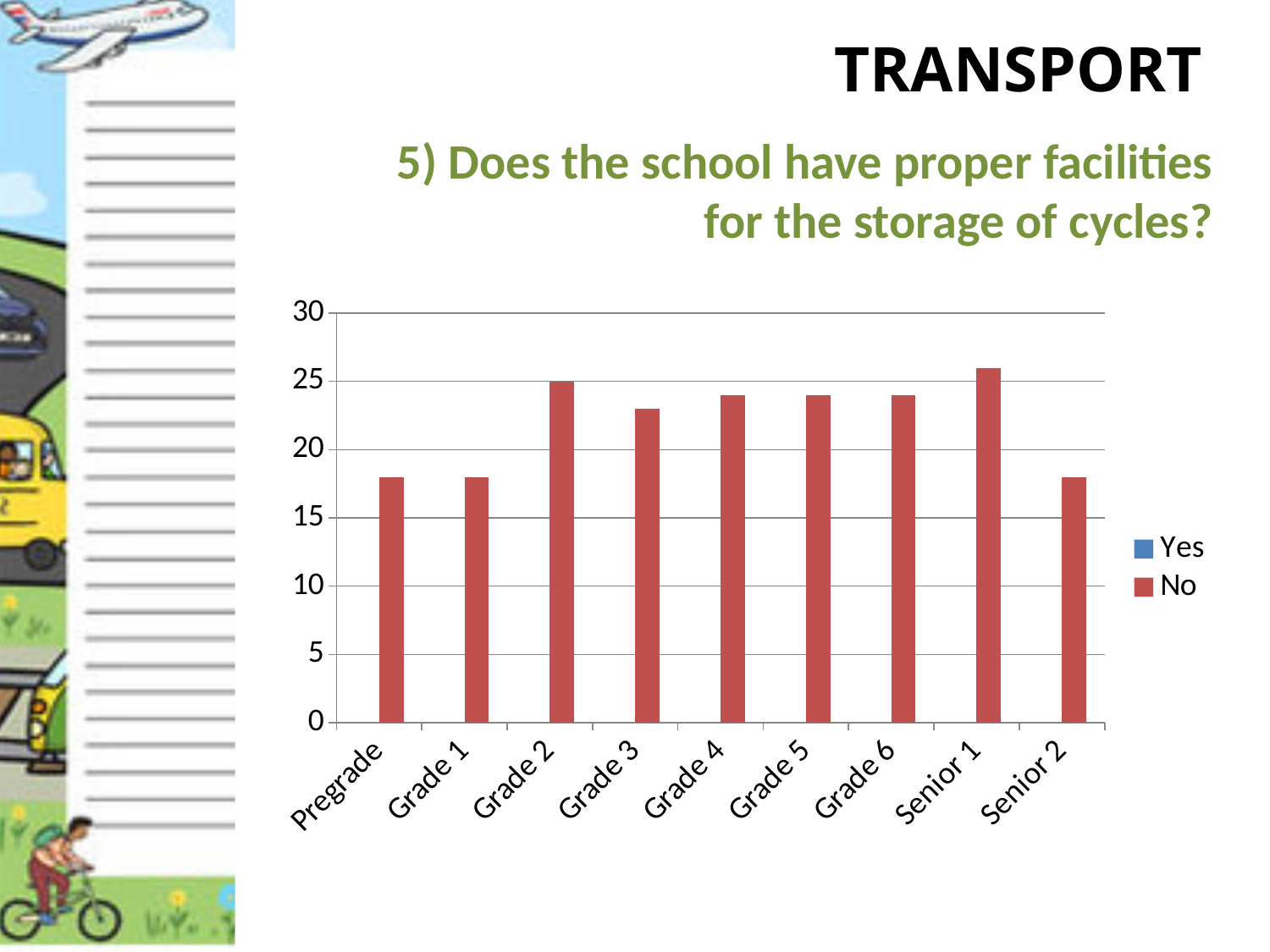
What kind of chart is shown on the slide? bar chart How many series does the chart's legend list? 2 Is the 'No' value for Grade 3 greater or less than 20? greater Is the 'No' value for Pregrade greater or less than 20? less Is the 'No' value for Senior 1 greater or less than 25? greater How many categories are shown on the x axis of the chart? 9 Which has a larger 'No' value, Grade 1 or Grade 2? Grade 2 What are the two series named in the chart's legend? Yes and No Which has a larger 'No' value, Senior 1 or Senior 2? Senior 1 Which series has visible bars in the chart? No